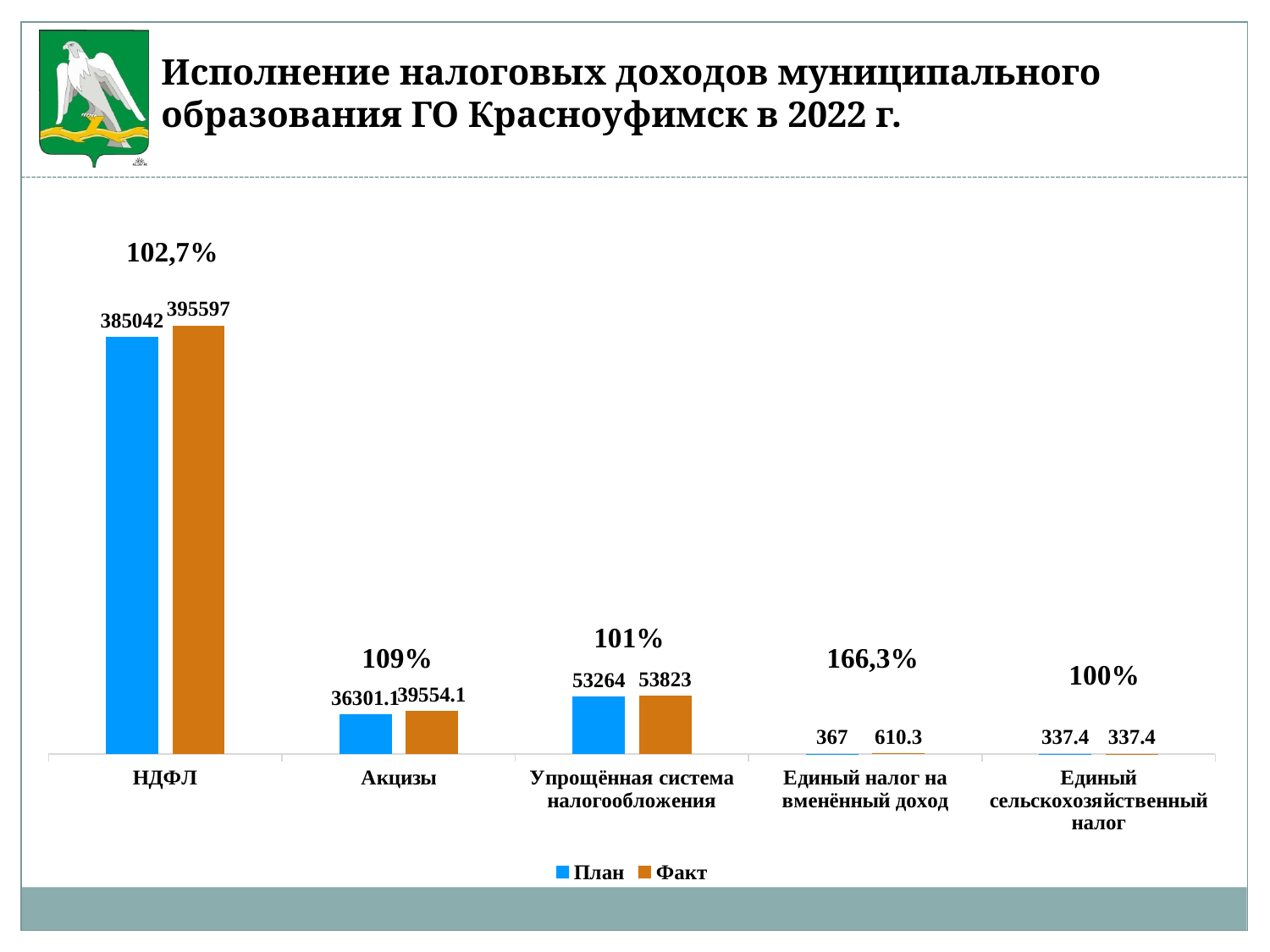
What is the difference between the Факт and План values for НДФЛ? 10555 Which category has the lowest План value? Единый сельскохозяйственный налог How many categories are shown on the x axis? 5 What is the Факт value for Единый налог на вменённый доход? 610.3 How many series does the legend list? 2 What is the План value for Упрощённая система налогообложения? 53264 What kind of chart is shown on the slide? bar chart Which category has the highest Факт value? НДФЛ What is the Факт value for НДФЛ? 395597 What is the Факт value for Акцизы? 39554.1 What percentage label is shown above the bars for Единый налог на вменённый доход? 166,3% What is the План value for НДФЛ? 385042